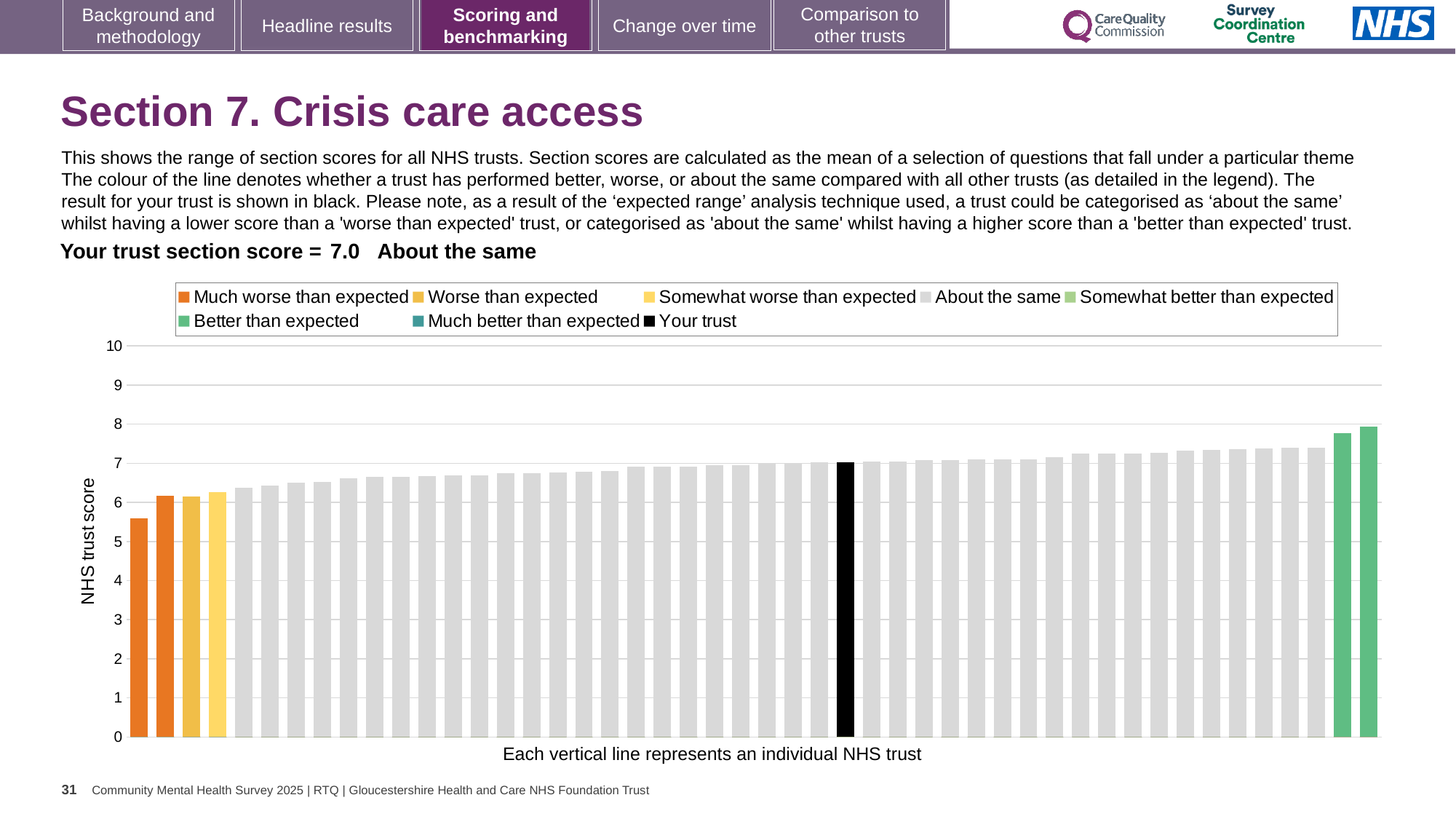
How many bars are coloured orange (Much worse than expected)? 2 Is the value of the highest (rightmost) bar greater or less than 7? greater What colour is the bar representing your trust? black What is the section score for your trust shown on the slide? 7.0 Is the value of the lowest (leftmost) bar greater or less than 6? less How is your trust's section score categorised compared with other trusts? About the same Is the value of the black bar for your trust greater or less than 6? greater Do the bar values rise or fall from left to right across the chart? rise What is the label on the vertical axis of the chart? NHS trust score What kind of chart is shown on the slide? bar chart How many entries does the chart legend list? 8 Which is larger: the black bar for your trust or the leftmost orange bar? the black bar for your trust